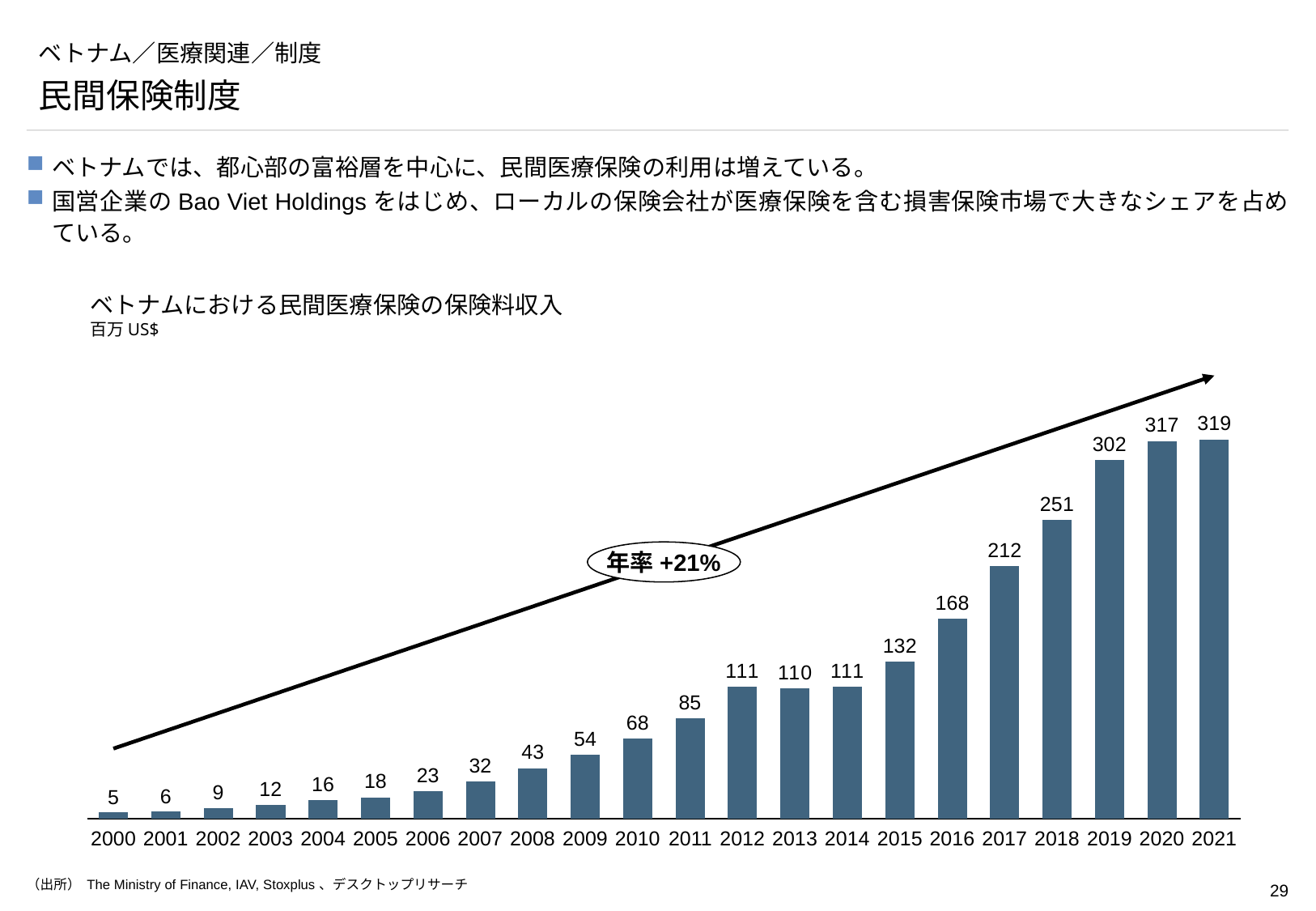
Which year has the lowest value? 2000 What is the difference between the values for 2021 and 2000? 314 Which year has the highest value? 2021 What kind of chart is this? bar chart What is the value for 2021? 319 What is the value for 2010? 68 What is the difference between the values for 2018 and 2017? 39 Do the values generally rise or fall from 2000 to 2021? rise What is the value for 2000? 5 What annual growth rate is shown in the oval label on the chart? 年率 +21% Which is larger, the value for 2013 or the value for 2015? 2015 How many years are shown on the x axis? 22